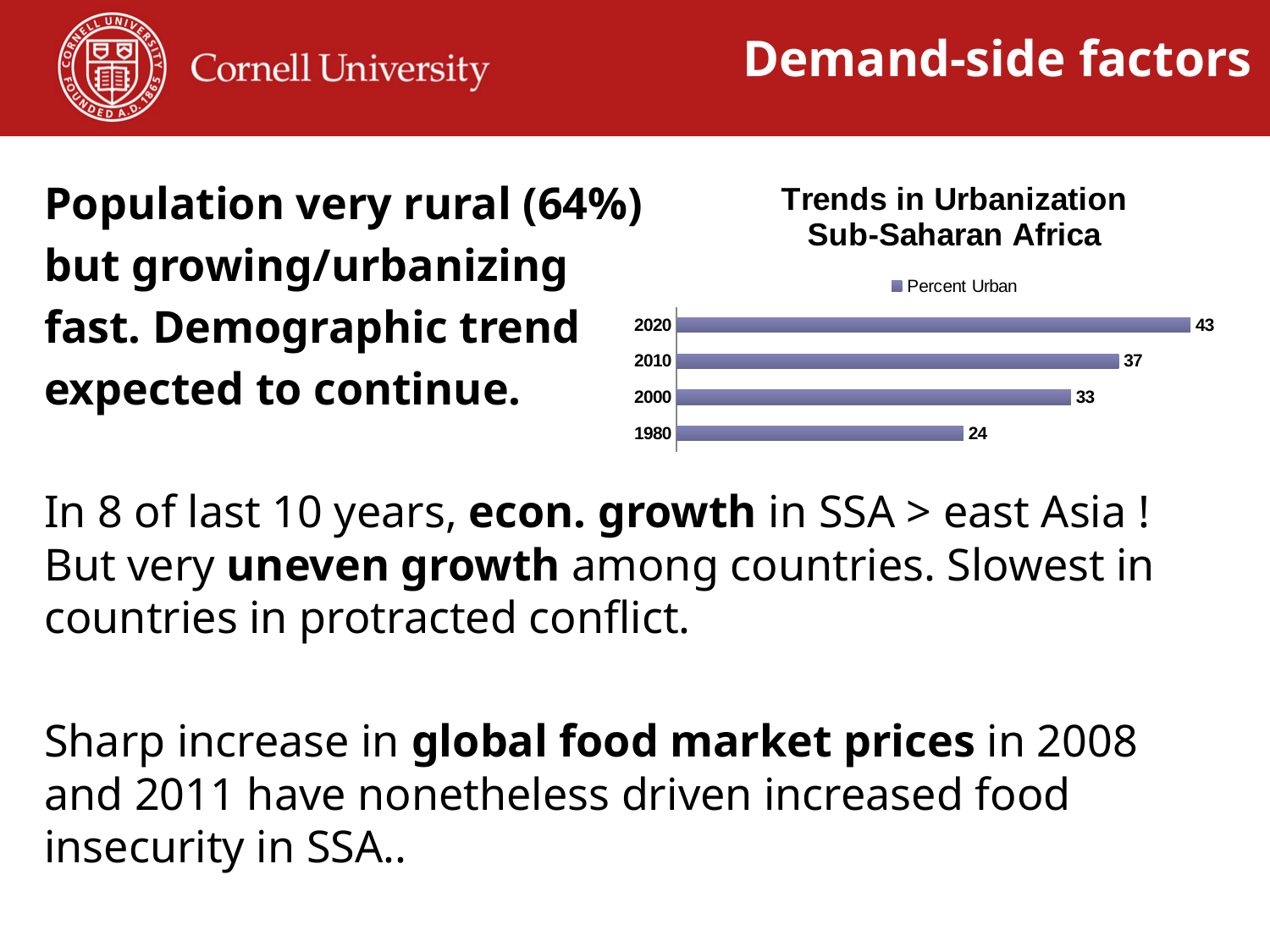
What is the Percent Urban value for 2020? 43 What kind of chart is shown on the slide? Bar chart Which year has the lowest Percent Urban value? 1980 What is the difference between the Percent Urban values for 2020 and 1980? 19 How many years are shown in the chart? 4 What is the title of the chart? Trends in Urbanization Sub-Saharan Africa What is the difference between the Percent Urban values for 2010 and 2000? 4 Which is larger, the Percent Urban value for 2010 or for 2000? 2010 What is the Percent Urban value for 1980? 24 Which year has the highest Percent Urban value? 2020 What is the Percent Urban value for 2000? 33 How many series does the legend list? 1